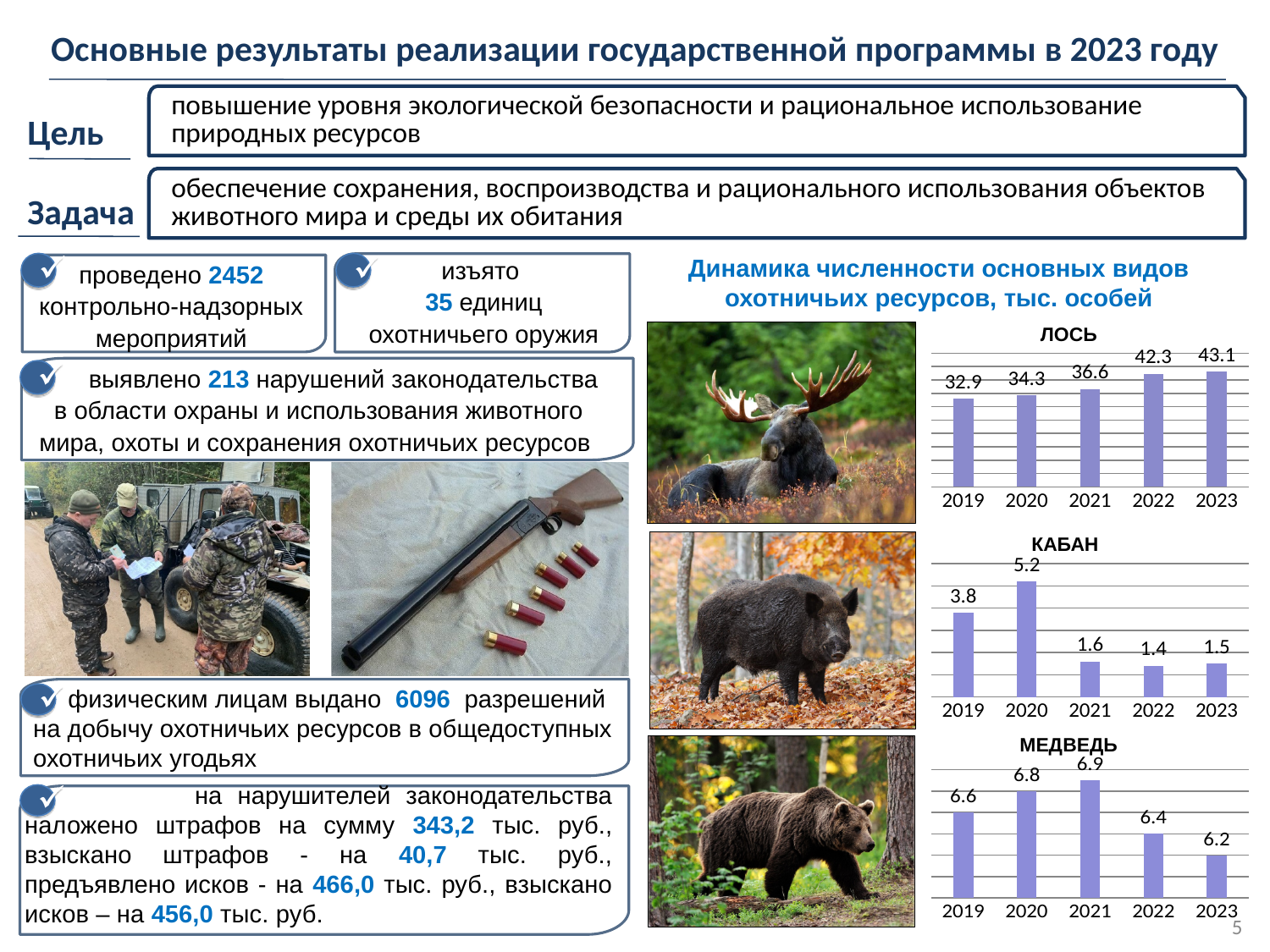
In the ЛОСЬ chart, do the values rise or fall from 2019 to 2023? rise In the КАБАН chart, what is the difference between the 2020 and 2021 values? 3.6 What kind of chart is the ЛОСЬ chart? bar chart In the ЛОСЬ chart, what is the value for 2023? 43.1 In the МЕДВЕДЬ chart, which is larger, the value for 2019 or the value for 2023? 2019 In the ЛОСЬ chart, which year has the lowest value? 2019 In the ЛОСЬ chart, what is the difference between the 2023 and 2019 values? 10.2 In the МЕДВЕДЬ chart, what is the value for 2021? 6.9 In the КАБАН chart, which year has the highest value? 2020 In the КАБАН chart, which year has the lowest value? 2022 How many years are shown on the x axis of the МЕДВЕДЬ chart? 5 In the КАБАН chart, what is the value for 2020? 5.2